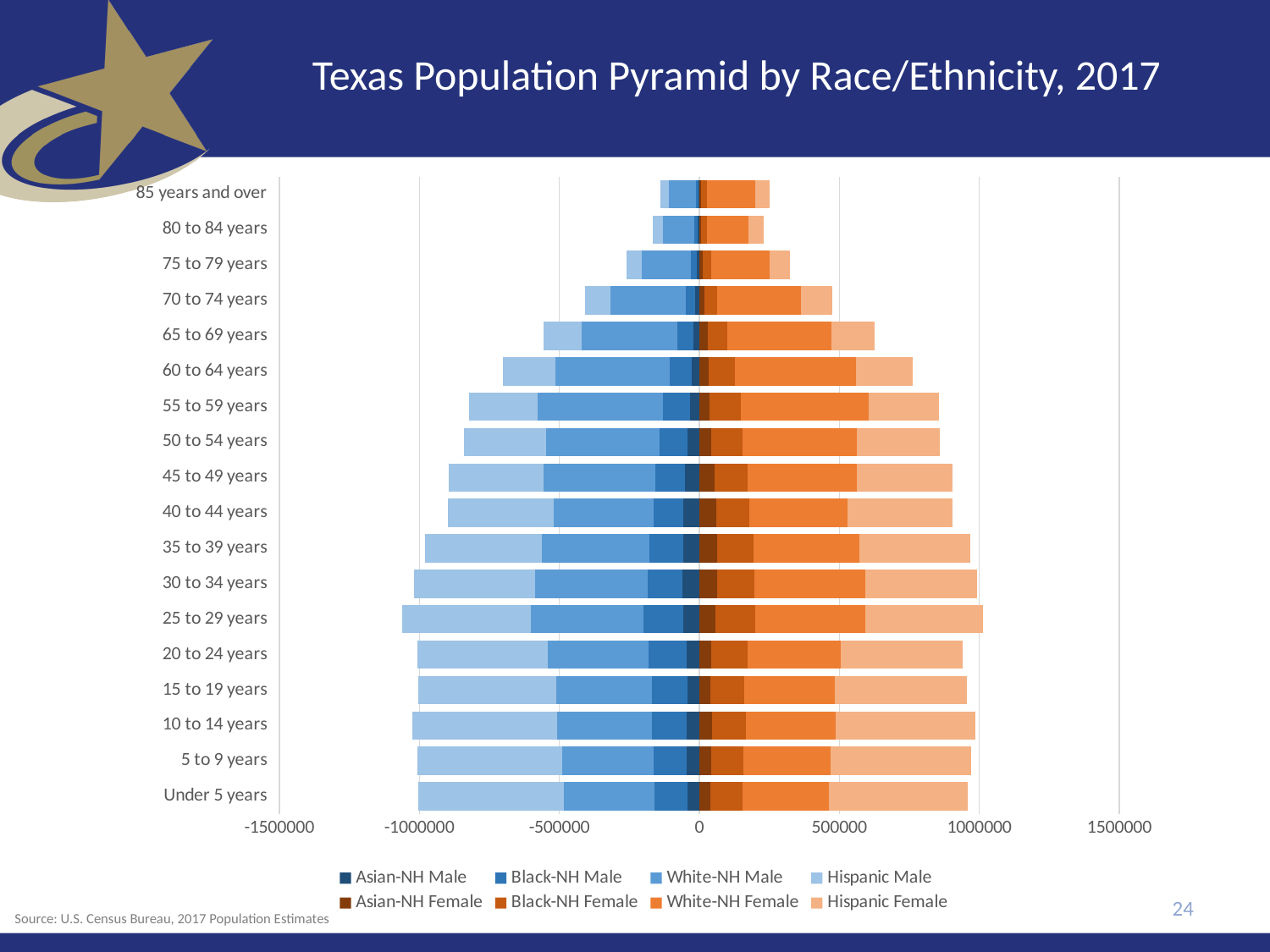
Which age group is listed at the bottom of the vertical axis? Under 5 years How many age groups are shown on the vertical axis? 18 How many series does the legend list? 8 Is the total female value for 10 to 14 years greater or less than 500000? greater Is the total female value for 35 to 39 years greater or less than 500000? greater What kind of chart is shown on the slide? Stacked bar chart (population pyramid) Is the total female value for 85 years and over greater or less than 500000? less What is the title of the chart? Texas Population Pyramid by Race/Ethnicity, 2017 Which has the larger total female value, 75 to 79 years or 85 years and over? 75 to 79 years Moving from the youngest age groups to the oldest, do the bars generally get longer or shorter? shorter Which has the larger total female value, 60 to 64 years or 30 to 34 years? 30 to 34 years